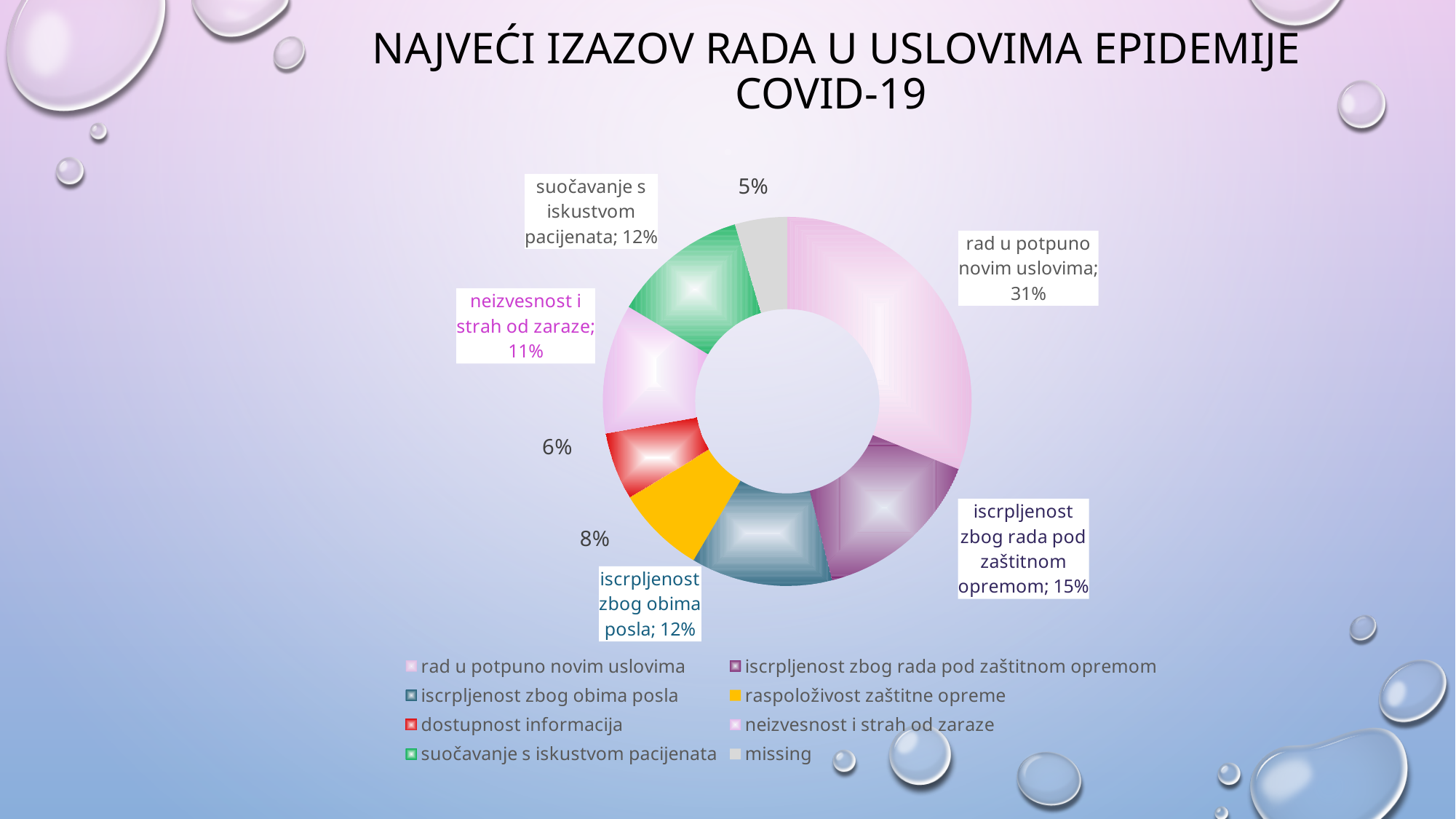
How many categories does the legend list? 8 What kind of chart is shown on the slide? Doughnut (pie) chart What percentage is shown for 'suočavanje s iskustvom pacijenata'? 12% What share is shown for 'iscrpljenost zbog rada pod zaštitnom opremom'? 15% Which is larger: the share for 'neizvesnost i strah od zaraze' or for 'iscrpljenost zbog obima posla'? iscrpljenost zbog obima posla What share of the chart is 'rad u potpuno novim uslovima'? 31% What share does the 'missing' slice have? 5% What is the difference in percentage points between 'rad u potpuno novim uslovima' and 'iscrpljenost zbog rada pod zaštitnom opremom'? 16 percentage points What percentage is labelled for 'neizvesnost i strah od zaraze'? 11% What is the title of the chart slide? NAJVEĆI IZAZOV RADA U USLOVIMA EPIDEMIJE COVID-19 Which category has the smallest share of the chart? missing Which category has the largest share of the chart? rad u potpuno novim uslovima